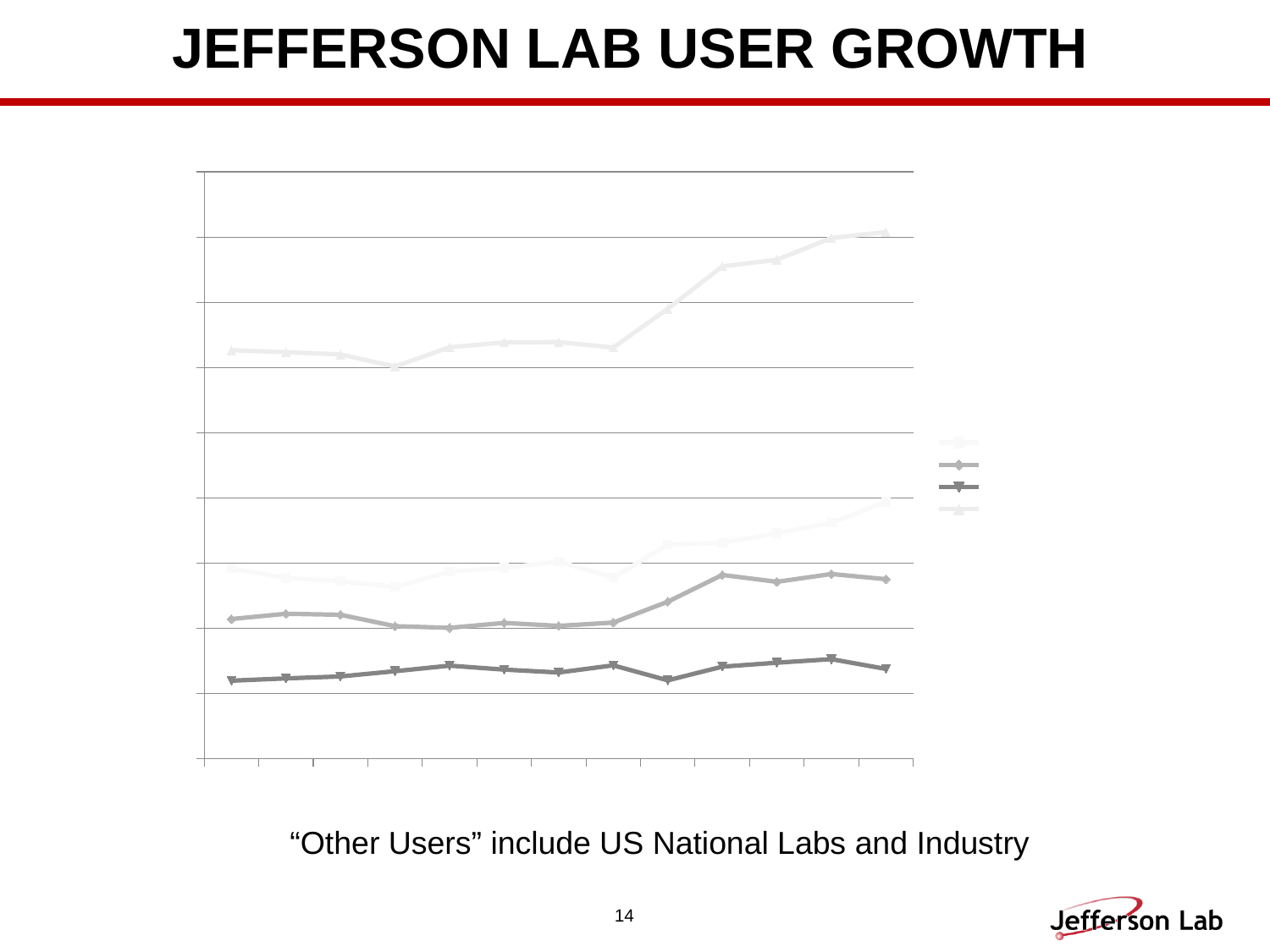
How many data points does each line in the chart have? 13 Does the second line from the top in the chart rise or fall overall from left to right? rise How many series does the chart's legend list? 4 What kind of chart is shown on the slide? line chart How many horizontal gridlines are drawn across the chart's plot area? 9 Does the topmost line in the chart rise or fall overall from left to right? rise